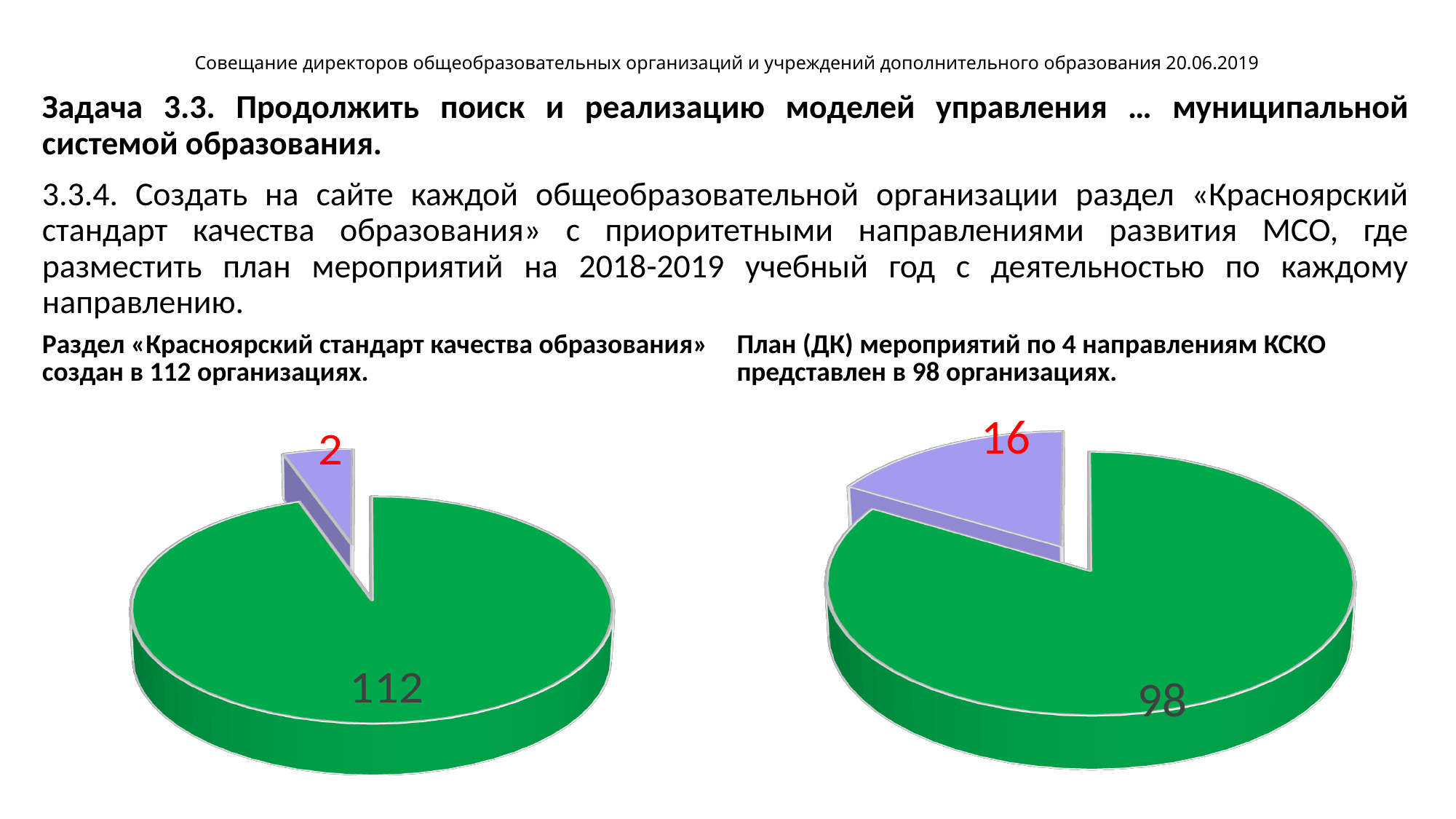
How many slices does the left pie chart have? 2 In the right pie chart, what is the difference between the green slice value and the purple slice value? 82 What kind of chart is shown on the right side of the slide? pie chart In the left pie chart, what value is shown on the purple slice? 2 What kind of chart is shown on the left side of the slide? pie chart In the right pie chart, what value is shown on the green slice? 98 In the left pie chart, what value is shown on the green slice? 112 In the right pie chart, which slice is larger, the green one or the purple one? the green one In the left pie chart, what is the difference between the green slice value and the purple slice value? 110 In the right pie chart, what value is shown on the purple slice? 16 What is the total of the two slice values in the right pie chart? 114 How many slices does the right pie chart have? 2